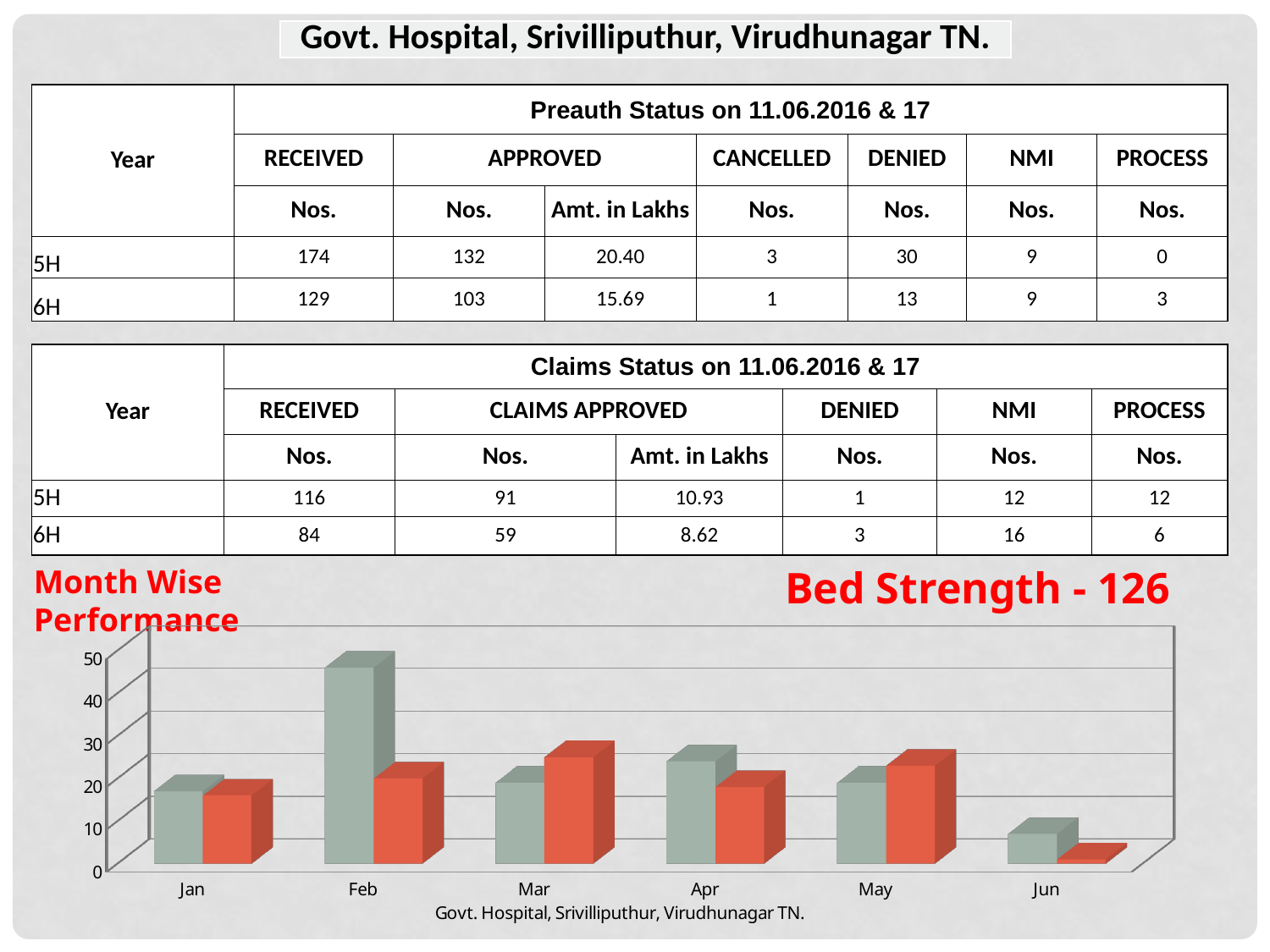
In the bar chart, which is larger for Mar: the grey bar or the red bar? The red bar Is the red bar for Jun greater or less than 10? less What caption is printed below the x axis of the bar chart? Govt. Hospital, Srivilliputhur, Virudhunagar TN. Is the grey bar for Feb greater or less than 40? greater How many months are shown on the x axis of the bar chart? 6 In the bar chart, which is larger for Feb: the grey bar or the red bar? The grey bar In the bar chart, which month has the shortest red bar? Jun How many bars are plotted for each month in the bar chart? 2 In the bar chart, which month has the tallest grey bar? Feb What kind of chart is shown at the bottom of the slide? Bar chart In the bar chart, which month has the shortest grey bar? Jun Is the grey bar for Jan greater or less than 20? less